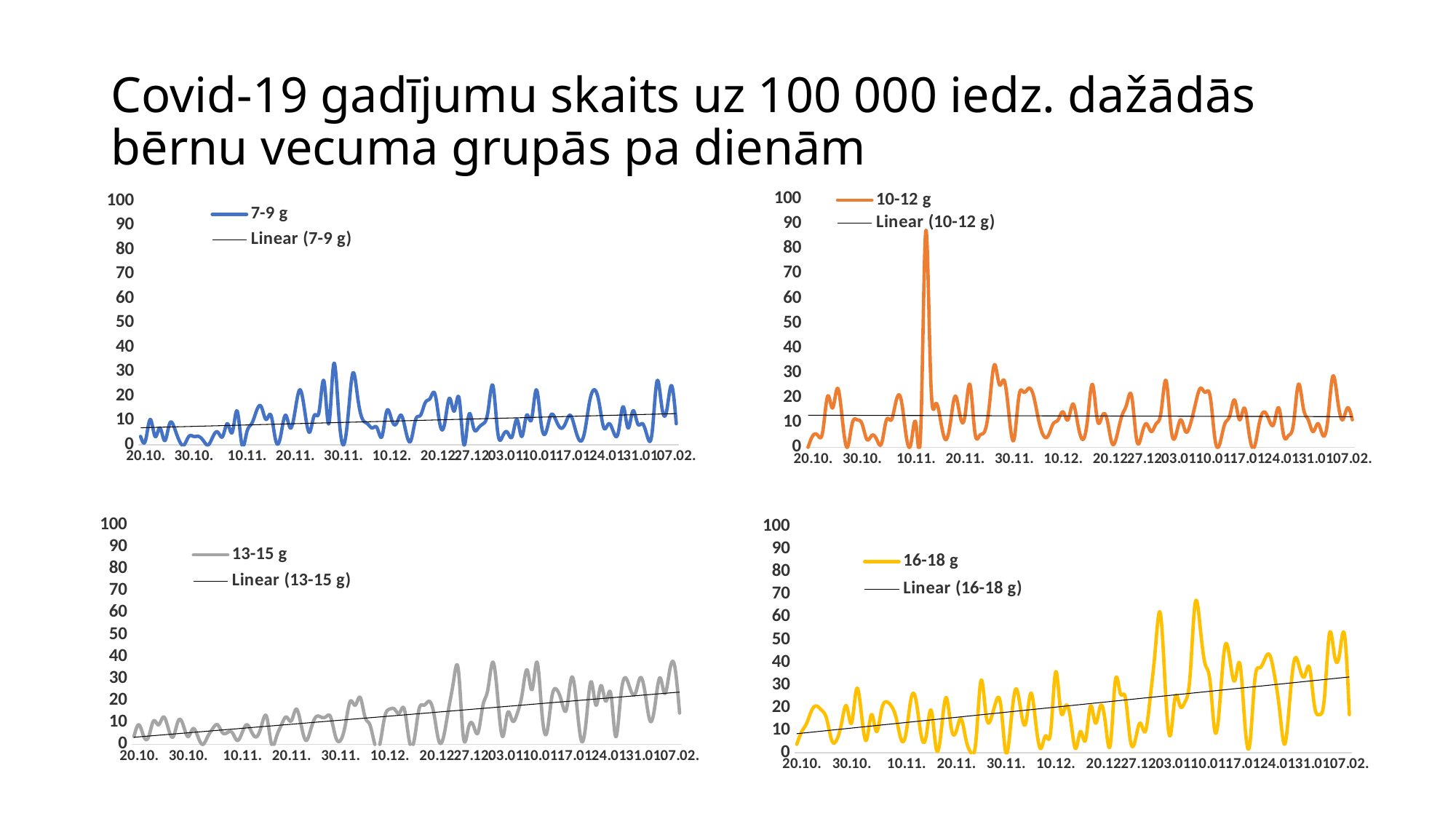
What kind of chart is the top-left chart (7-9 g)? line chart In the bottom-right chart (16-18 g), what is the name of the second legend entry? Linear (16-18 g) In the top-left chart (7-9 g), is the highest peak of the line greater or less than 40? less In the top-right chart (10-12 g), is the highest peak of the line greater or less than 50? greater In the bottom-left chart (13-15 g), does the linear trend line rise or fall from left to right? rise How many entries does the legend of the top-right chart (10-12 g) list? 2 In the bottom-right chart (16-18 g), is the highest peak of the line greater or less than 50? greater Which chart has the higher maximum peak: the top-left chart (7-9 g) or the bottom-right chart (16-18 g)? 16-18 g How many charts are shown on the slide? 4 In the bottom-right chart (16-18 g), does the linear trend line rise or fall from left to right? rise What colour is the data line in the bottom-left chart (13-15 g)? grey